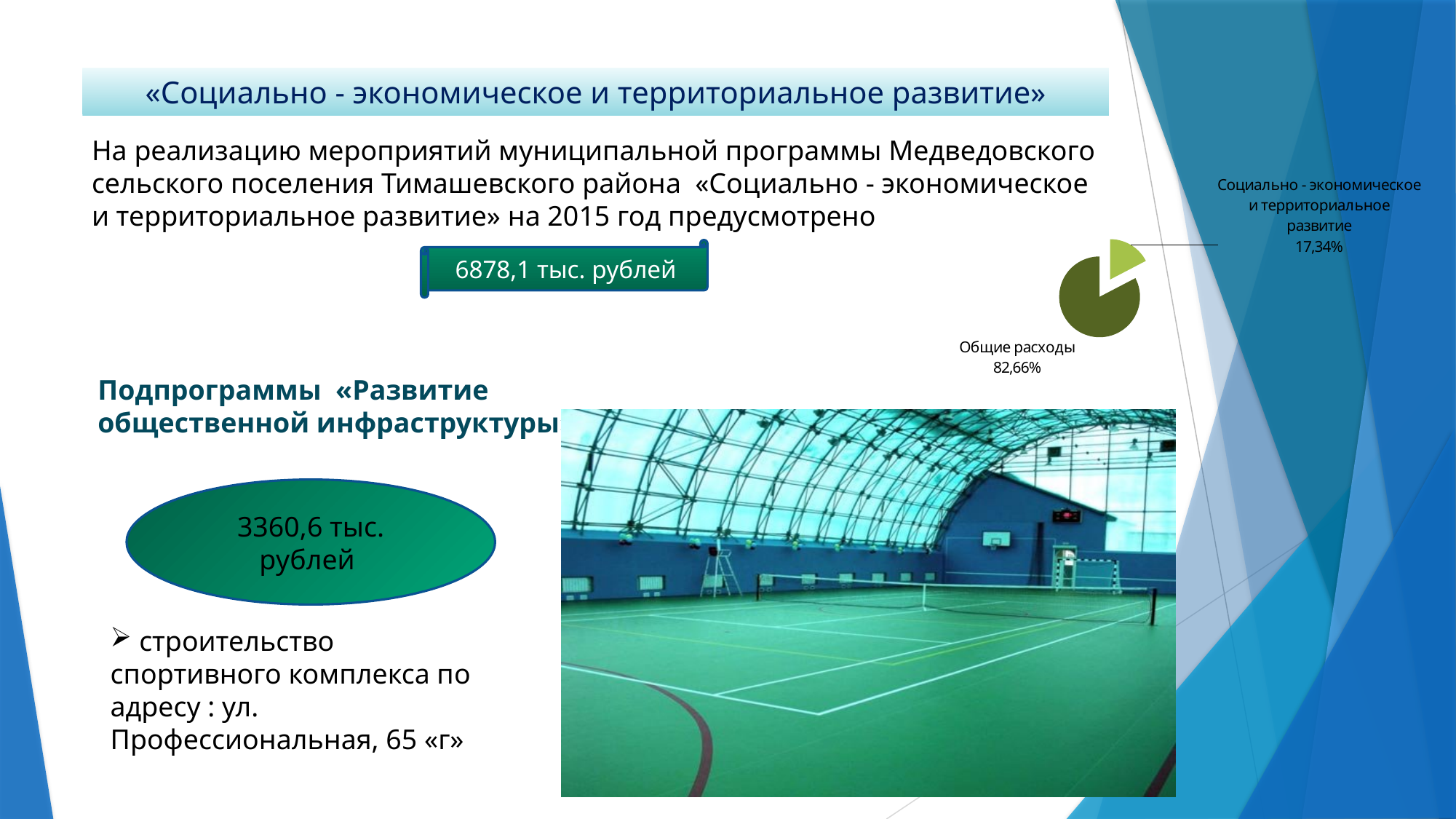
Is the share for "Общие расходы" in the pie chart greater or less than 50%? greater Which slice of the pie chart is the largest? Общие расходы What kind of chart is shown on the slide? pie chart What colour is the "Общие расходы" slice in the pie chart? dark olive green What is the difference in percentage points between the "Общие расходы" slice and the "Социально - экономическое и территориальное развитие" slice? 65,32 What share of the pie chart is labelled "Общие расходы"? 82,66% What colour is the "Социально - экономическое и территориальное развитие" slice in the pie chart? light green In the pie chart, which is larger: "Общие расходы" or "Социально - экономическое и территориальное развитие"? Общие расходы How many slices does the pie chart have? 2 Which slice of the pie chart is the smallest? Социально - экономическое и территориальное развитие What share of the pie chart is labelled "Социально - экономическое и территориальное развитие"? 17,34% Is the share for "Социально - экономическое и территориальное развитие" in the pie chart greater or less than 25%? less